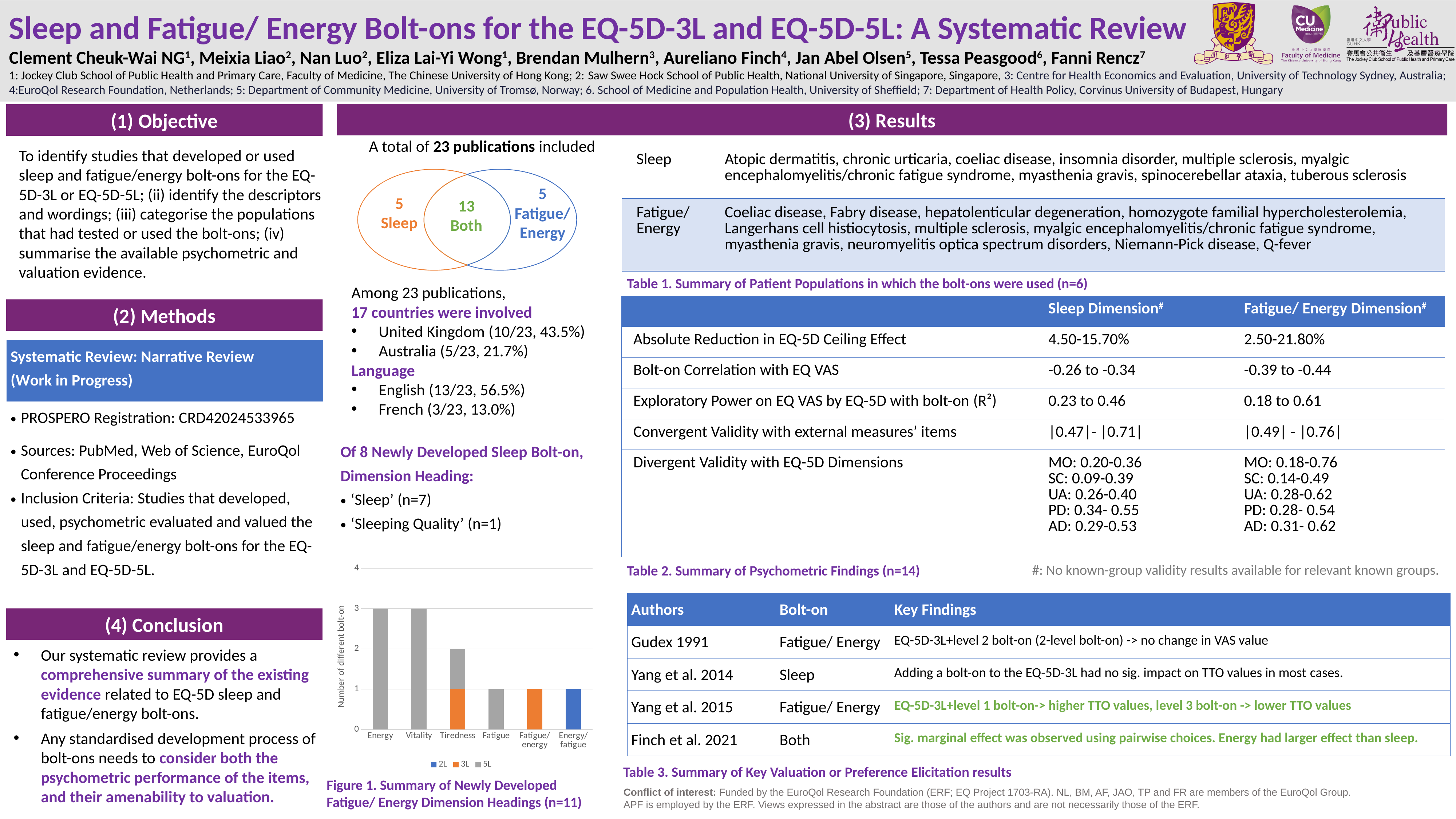
In the Figure 1 bar chart, what is the value of the 5L bar for Energy? 3 In the Figure 1 bar chart, which series is plotted for Energy/fatigue? 2L In the Figure 1 bar chart, which is larger: the 5L bar for Energy or the 5L bar for Fatigue? Energy In the Figure 1 bar chart, what is the value of the 3L bar for Tiredness? 1 In the Figure 1 bar chart, what is the label of the y axis? Number of different bolt-on In the Figure 1 bar chart, what is the difference between the 5L bar for Vitality and the 5L bar for Tiredness? 1 In the Venn diagram, how many publications are in the 'Both' overlap? 13 In the Figure 1 bar chart, how many categories are shown on the x axis? 6 In the Figure 1 bar chart, what is the value of the 5L bar for Tiredness? 2 In the Figure 1 bar chart, how many series does the legend list? 3 In the Figure 1 bar chart, what kind of chart is used? bar chart In the Figure 1 bar chart, what are the legend entries? 2L, 3L, 5L